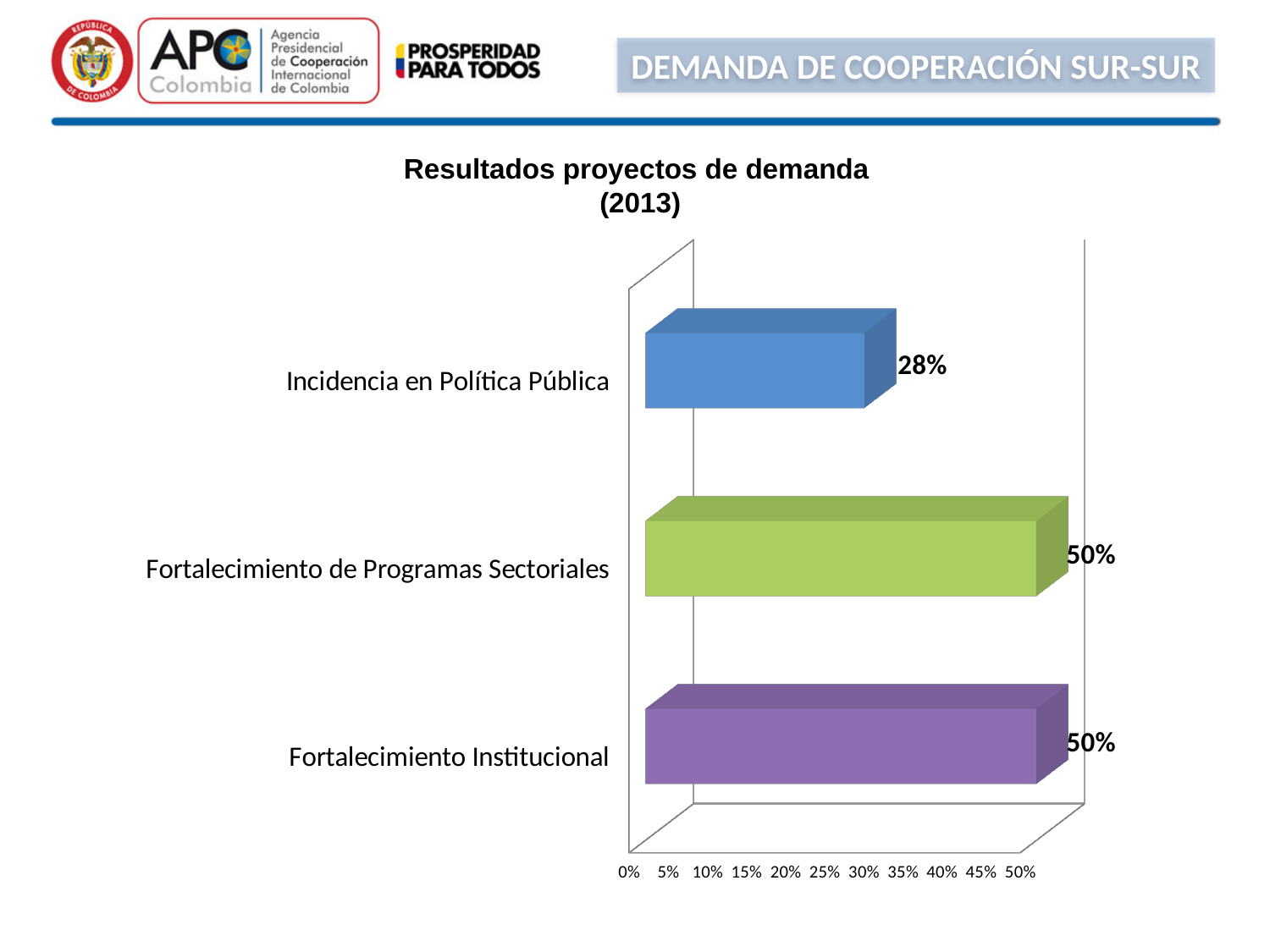
How many categories are shown in the chart? 3 What is the difference between the values for Fortalecimiento Institucional and Incidencia en Política Pública? 22% What kind of chart is shown on the slide? bar chart What colour is the bar for Fortalecimiento Institucional? purple What is the value for Fortalecimiento de Programas Sectoriales? 50% What is the highest value shown on the x axis? 50% What is the title of the chart? Resultados proyectos de demanda (2013) Which category has the lowest value? Incidencia en Política Pública What is the value for Incidencia en Política Pública? 28% Is the value for Incidencia en Política Pública greater or less than 40%? less What is the value for Fortalecimiento Institucional? 50% Which is larger, the value for Fortalecimiento de Programas Sectoriales or the value for Incidencia en Política Pública? Fortalecimiento de Programas Sectoriales